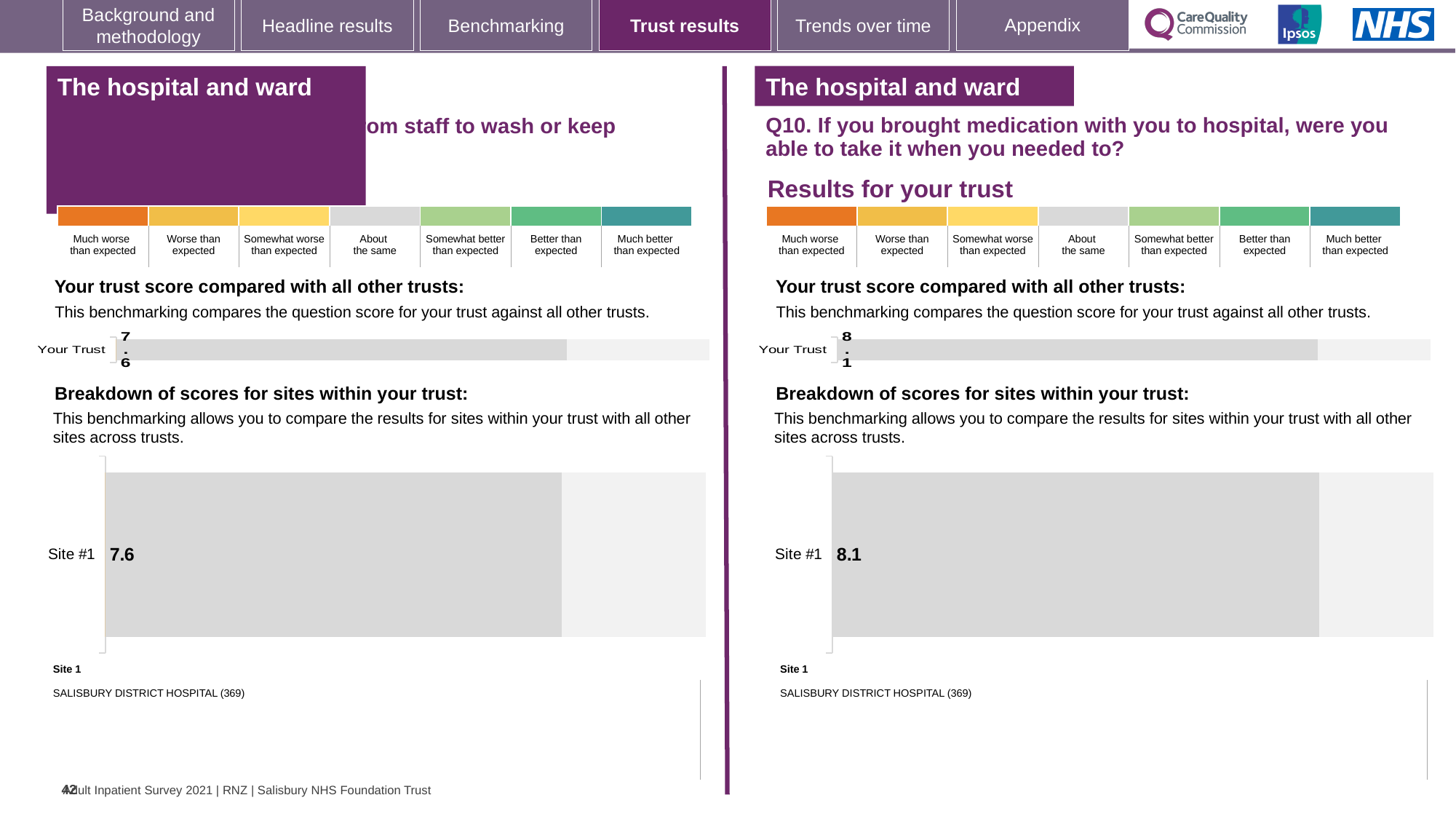
Which site is listed as Site 1 below the breakdown chart on the right half of the slide (Q10)? SALISBURY DISTRICT HOSPITAL (369) How many sites are shown in the breakdown of scores chart on the right half of the slide (Q10)? 1 On the right half of the slide, what is the question number and topic of the question being reported? Q10. If you brought medication with you to hospital, were you able to take it when you needed to? On the right half of the slide (Q10, medication), what is the score shown for Site #1 in the breakdown of scores for sites within your trust? 8.1 On the left half of the slide, what is the score shown for Your Trust in the 'Your trust score compared with all other trusts' chart? 7.6 How many sites are shown in the breakdown of scores chart on the left half of the slide? 1 Is the Site #1 score on the left half of the slide equal to the Your Trust score on the same half? Yes, both are 7.6 On the left half of the slide, what is the score shown for Site #1 in the breakdown of scores for sites within your trust? 7.6 What kind of chart is used for the breakdown of scores for sites within your trust on the right half of the slide (Q10)? Bar chart Which is larger: the Site #1 score on the left half of the slide or the Site #1 score on the right half (Q10)? Right half (Q10), 8.1 What is the difference between the Site #1 score on the right half of the slide (Q10) and the Site #1 score on the left half? 0.5 On the right half of the slide (Q10, medication), what is the score shown for Your Trust in the 'Your trust score compared with all other trusts' chart? 8.1